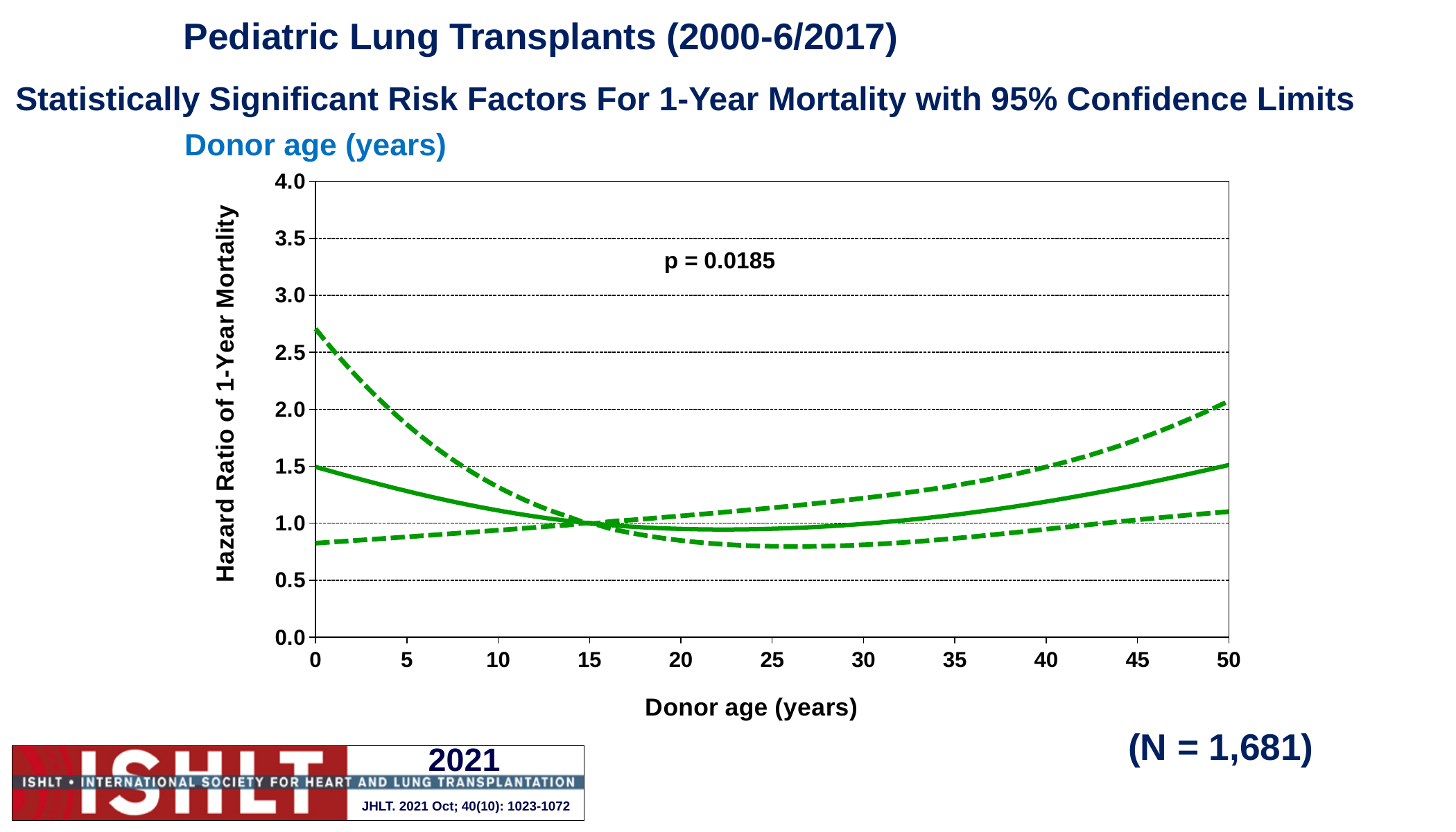
Is the value of the lower dashed confidence limit at donor age 0 greater or less than 1.0? less What is the label of the y axis? Hazard Ratio of 1-Year Mortality Is the value of the solid hazard ratio line at donor age 25 greater or less than 1.5? less Does the solid hazard ratio line rise or fall between donor age 30 and donor age 50? rise What kind of chart is shown on the slide? line chart Is the value of the upper dashed confidence limit at donor age 30 greater or less than 1.0? greater How many lines are plotted on the chart? 3 Does the solid hazard ratio line rise or fall between donor age 0 and donor age 15? fall What p-value is printed on the chart? p = 0.0185